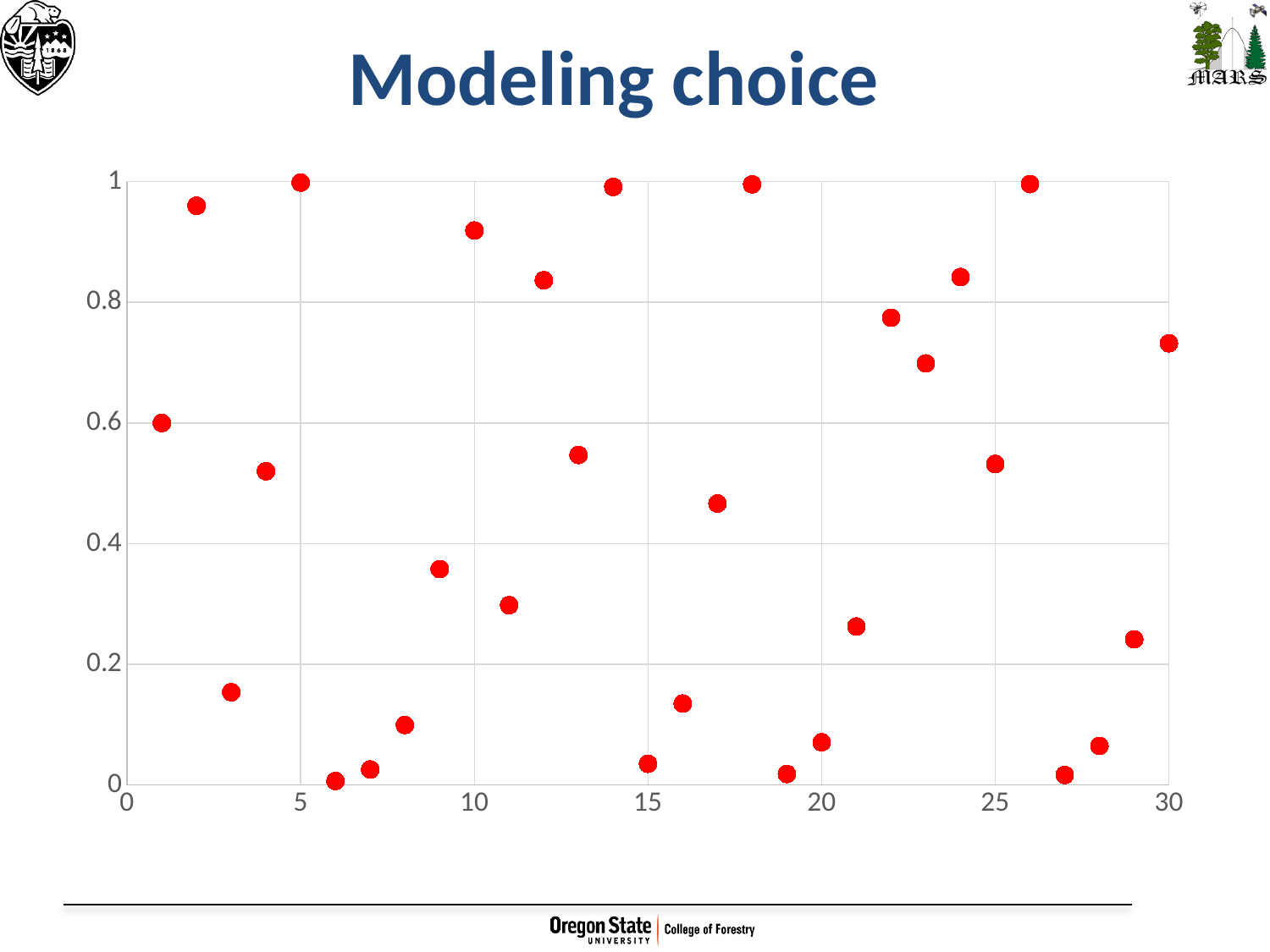
What kind of chart is shown on the slide? Scatter chart What is the highest tick value shown on the x axis of the chart? 30 Which has the larger value, the point at x = 2 or the point at x = 3? x = 2 Is the value for x = 20 greater or less than 0.2? less Is the value for x = 1 greater or less than 0.4? greater Which has the larger value, the point at x = 24 or the point at x = 21? x = 24 Which has the larger value, the point at x = 13 or the point at x = 15? x = 13 How many data points are plotted in the chart? 30 Is the value for x = 30 greater or less than 0.6? greater What is the title of the slide containing the chart? Modeling choice